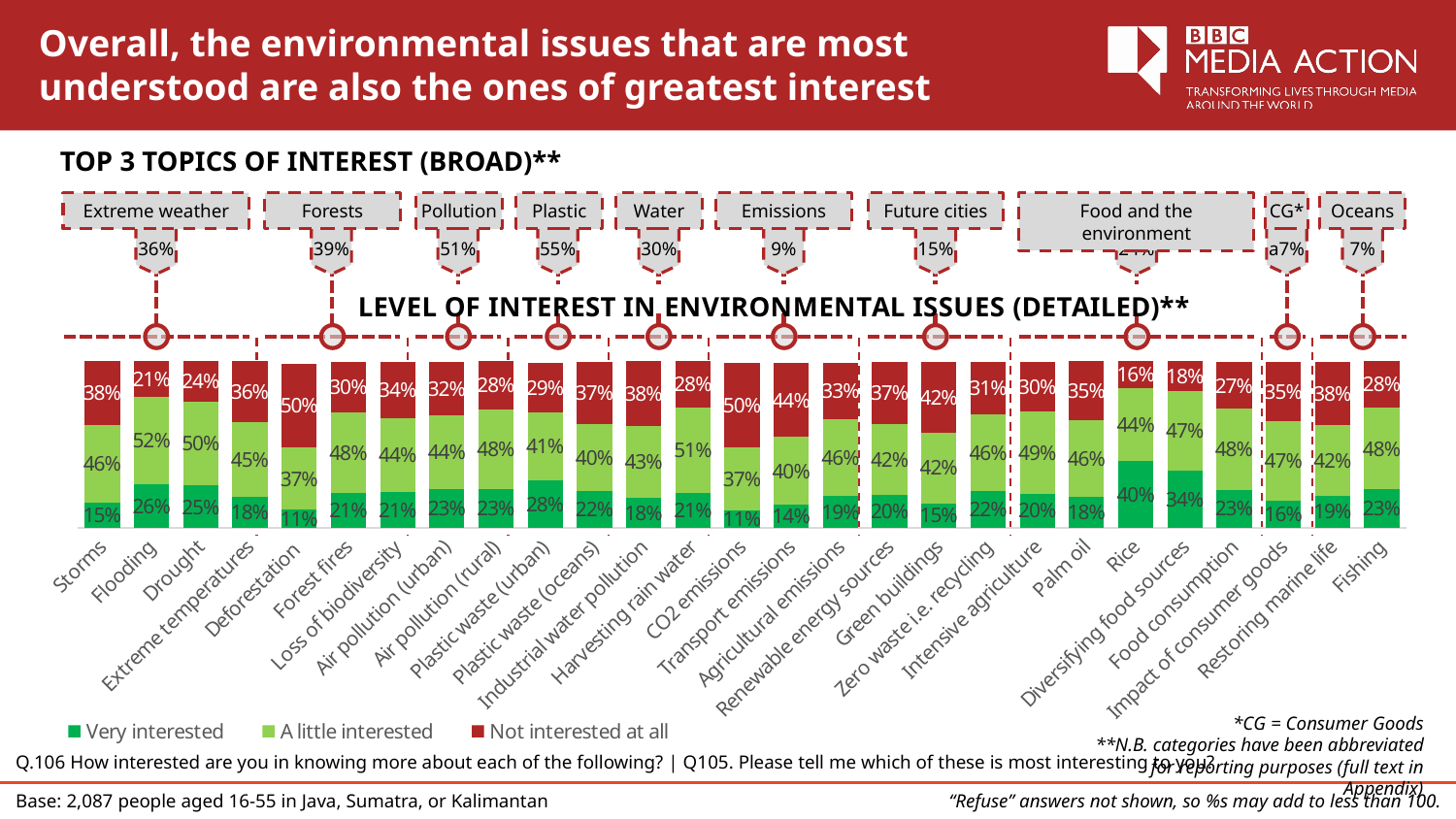
In the level of interest chart, what percentage of respondents are 'Not interested at all' in Deforestation? 50% How many series does the legend of the level of interest chart list? 3 In the level of interest chart, which has a larger 'Not interested at all' value: CO2 emissions or Flooding? CO2 emissions How many categories are shown on the x axis of the level of interest chart? 27 In the level of interest chart, what percentage of respondents are 'A little interested' in Flooding? 52% What kind of chart is used to show the level of interest in environmental issues (detailed)? Stacked bar chart In the level of interest chart, what percentage of respondents are 'Very interested' in Rice? 40% In the top 3 topics of interest (broad) section, what percentage is shown for Plastic? 55% In the level of interest chart, what is the total of the three segments for the Storms bar? 99% In the level of interest chart, what is the difference between the 'Very interested' values for Rice and Storms? 25% In the level of interest chart, which category has the highest 'Very interested' value? Rice In the level of interest chart, which category has the lowest 'Not interested at all' value? Rice